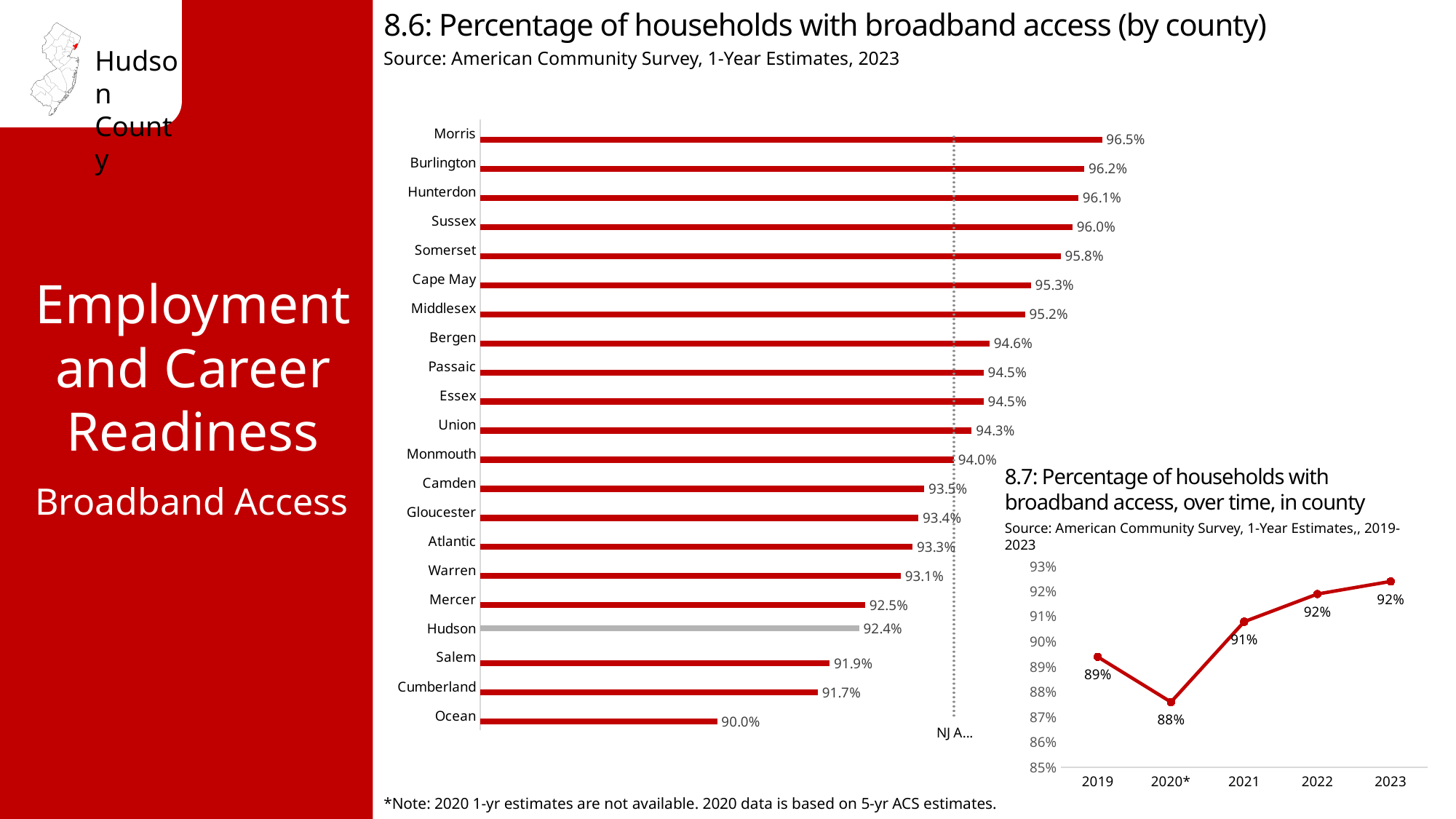
What kind of chart is chart 8.6? Bar chart In chart 8.6, which county has the lowest percentage of households with broadband access? Ocean In chart 8.6 (Percentage of households with broadband access by county), what is the value for Hudson? 92.4% In chart 8.7, which year has the lowest value? 2020* In chart 8.6, which has a higher value, Mercer or Hudson? Mercer In chart 8.6, what is the difference between the values for Morris and Ocean? 6.5 percentage points In chart 8.6, which county has the highest percentage of households with broadband access? Morris In chart 8.7, do the values rise or fall from 2020* to 2023? Rise In chart 8.7 (broadband access over time in county), what is the value for 2020*? 88% In chart 8.6, how many counties are shown? 21 In chart 8.6, what is the value for Cumberland? 91.7% In chart 8.7, how many data points are plotted? 5